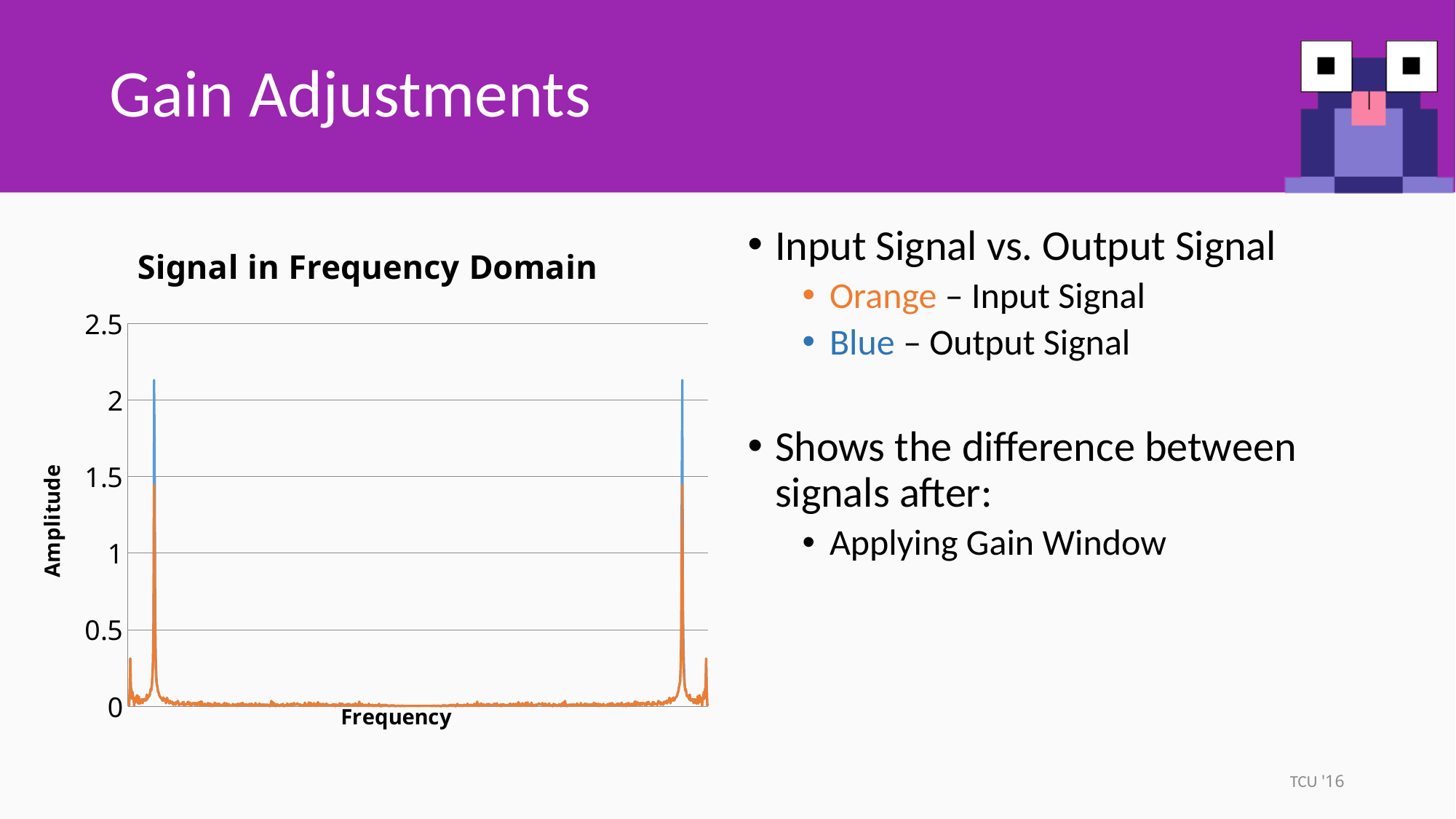
Is the peak amplitude of the orange (Input Signal) line greater or less than 1? greater Which signal reaches a higher peak amplitude, the Input Signal (orange) or the Output Signal (blue)? Output Signal (blue) Is the peak amplitude of the blue (Output Signal) line greater or less than 2.5? less Is the peak amplitude of the orange (Input Signal) line greater or less than 2? less What is the highest value shown on the Amplitude axis? 2.5 What kind of chart is shown on the slide? line chart How many major peaks does the signal show across the frequency axis? 2 What is the title of the chart? Signal in Frequency Domain According to the slide, which colour represents the Input Signal in the chart? Orange